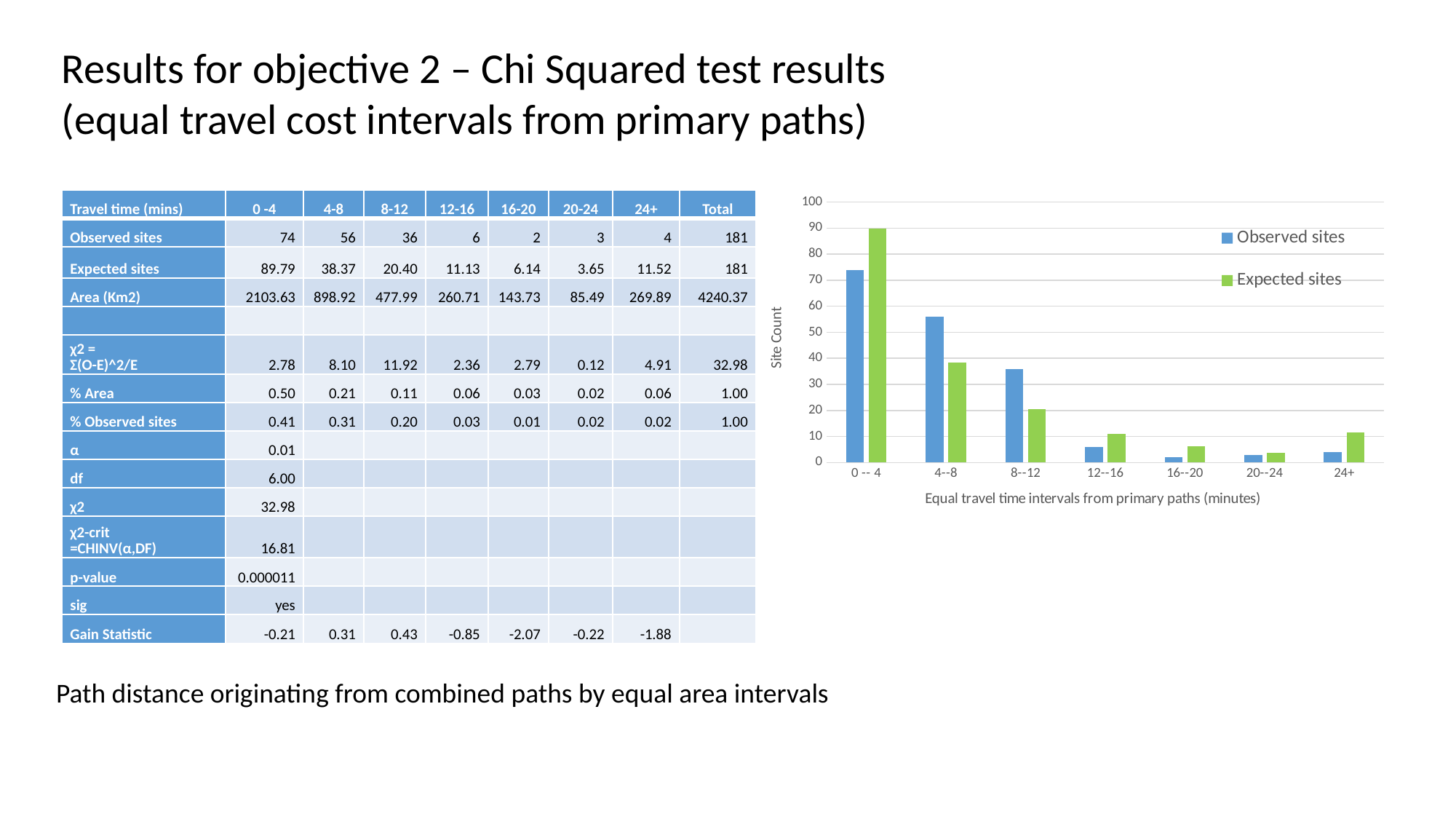
What is the title of the chart's y axis? Site Count How many travel time interval categories are plotted on the chart's x axis? 7 Is the Expected sites value for 4--8 greater or less than 40? less Do the Observed sites values rise or fall from 0 -- 4 to 16--20? fall For the 4--8 interval, which is larger: Observed sites or Expected sites? Observed sites Is the Observed sites value for 0 -- 4 greater or less than 70? greater Which travel time interval has the highest Observed sites bar? 0 -- 4 According to the table on the slide, what is the Observed sites value plotted for the 0 -- 4 interval? 74 What kind of chart is shown on the right of the slide? bar chart Which travel time interval has the lowest Expected sites bar? 20--24 How many series does the chart's legend list? 2 For the 0 -- 4 interval, which is larger: Observed sites or Expected sites? Expected sites